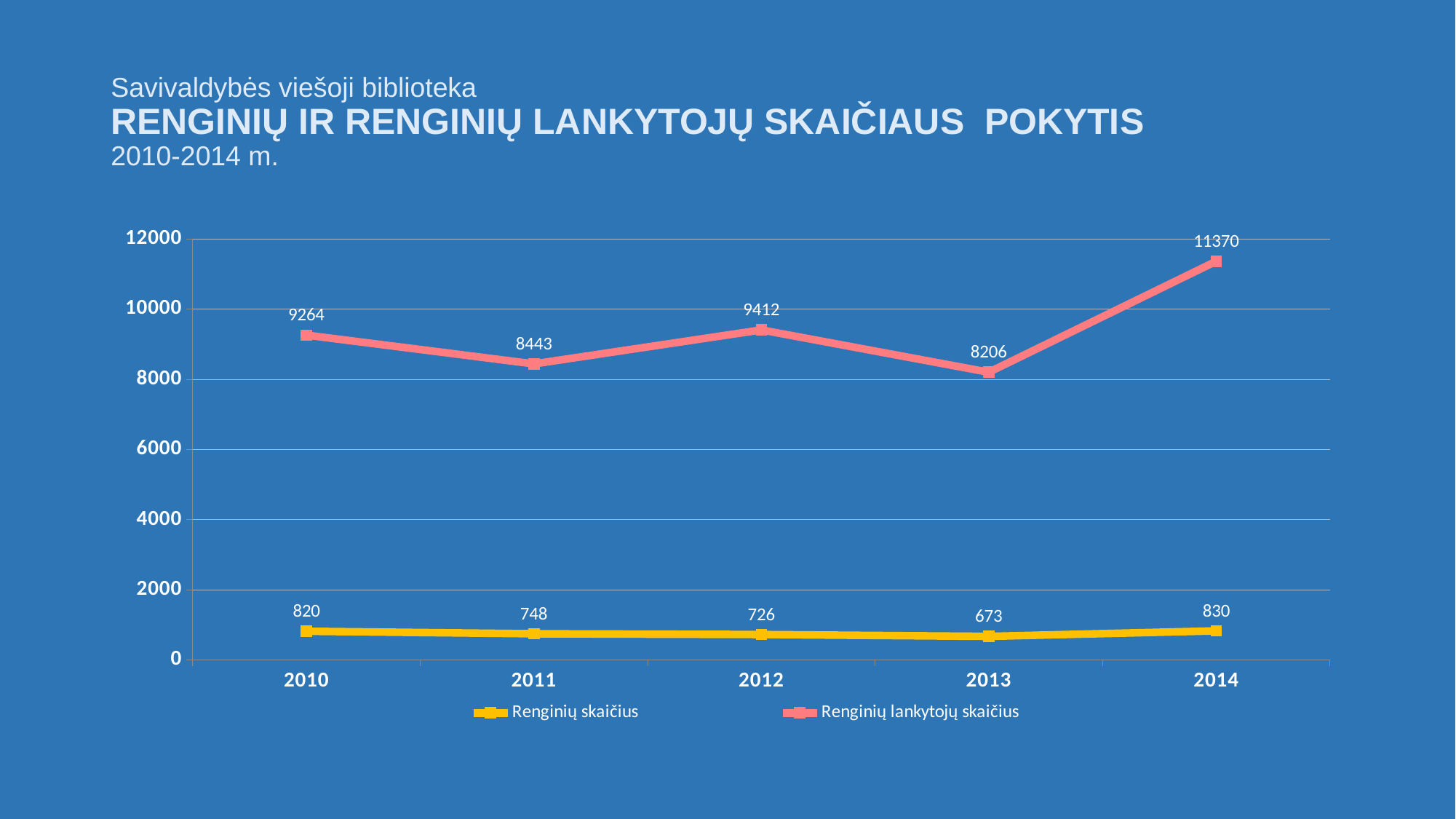
What is the value of Renginių lankytojų skaičius in 2014? 11370 What is the value of Renginių skaičius in 2013? 673 What is the difference between Renginių lankytojų skaičius in 2014 and 2013? 3164 In which year is Renginių skaičius lowest? 2013 What kind of chart is shown on the slide? line chart What is the difference between Renginių skaičius in 2010 and 2011? 72 Which is larger, Renginių lankytojų skaičius in 2010 or in 2012? 2012 Is the value of Renginių lankytojų skaičius in 2013 greater or less than 10000? less In which year is Renginių lankytojų skaičius highest? 2014 How many years are shown on the x axis? 5 What is the value of Renginių lankytojų skaičius in 2011? 8443 How many series does the legend list? 2